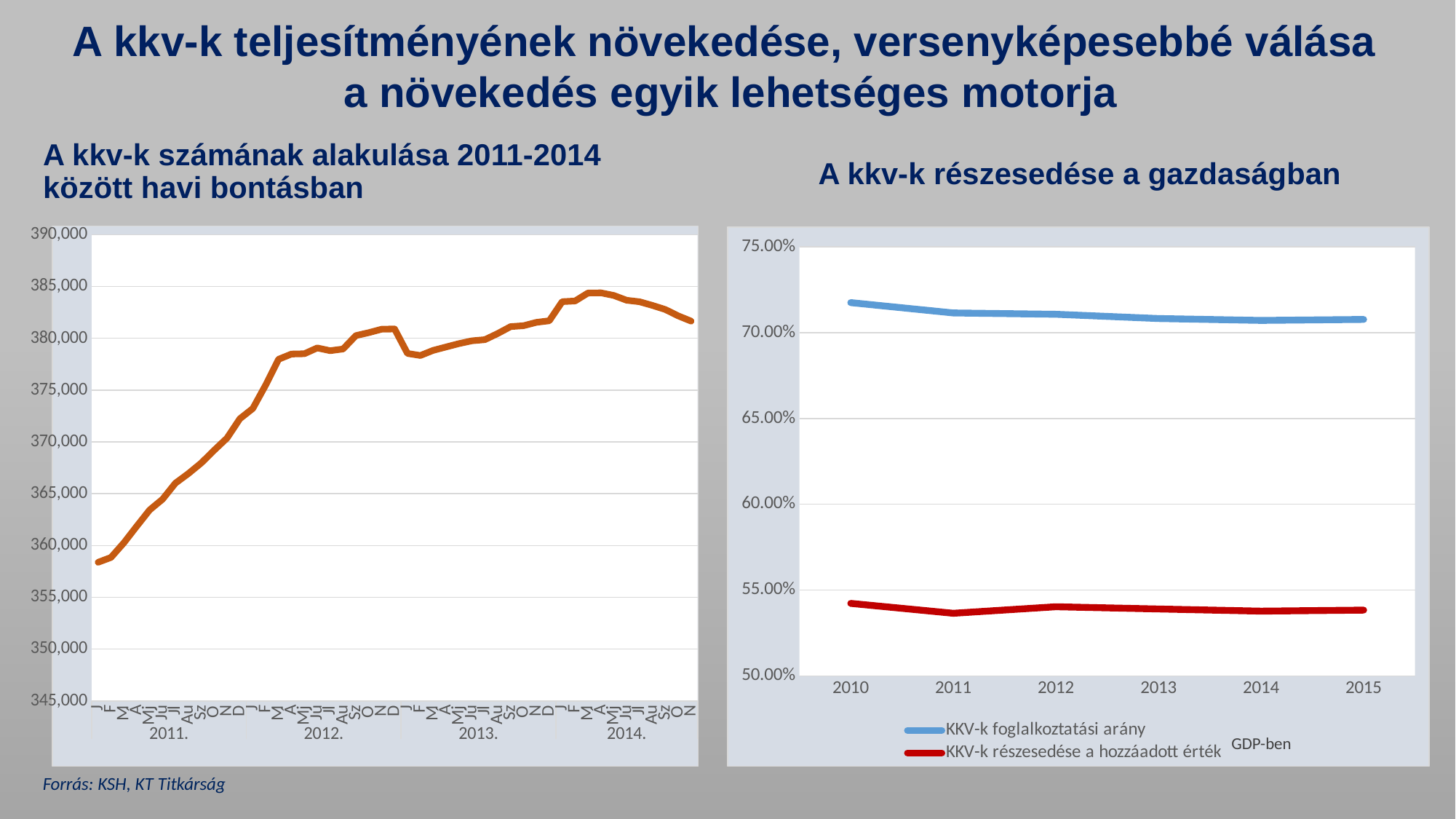
In the right chart, 'A kkv-k részesedése a gazdaságban', is the value of 'KKV-k részesedése a hozzáadott érték GDP-ben' in 2015 greater or less than 55.00%? less In the right chart, 'A kkv-k részesedése a gazdaságban', which series has the higher values, 'KKV-k foglalkoztatási arány' or 'KKV-k részesedése a hozzáadott érték GDP-ben'? KKV-k foglalkoztatási arány What kind of chart is the right chart, 'A kkv-k részesedése a gazdaságban'? line chart In the right chart, 'A kkv-k részesedése a gazdaságban', how many years are shown on the x axis? 6 What kind of chart is the left chart, 'A kkv-k számának alakulása 2011-2014 között havi bontásban'? line chart In the right chart, 'A kkv-k részesedése a gazdaságban', what colour is the line for 'KKV-k foglalkoztatási arány'? blue In the left chart, 'A kkv-k számának alakulása 2011-2014 között havi bontásban', is the value at the start of 2011 greater or less than 360,000? less In the left chart, 'A kkv-k számának alakulása 2011-2014 között havi bontásban', is the highest value of the line greater or less than 380,000? greater In the left chart, 'A kkv-k számának alakulása 2011-2014 között havi bontásban', does the number of SMEs overall rise or fall from 2011 to 2014? rise In the left chart, 'A kkv-k számának alakulása 2011-2014 között havi bontásban', how many years are labelled on the x axis? 4 In the right chart, 'A kkv-k részesedése a gazdaságban', how many series does the legend list? 2